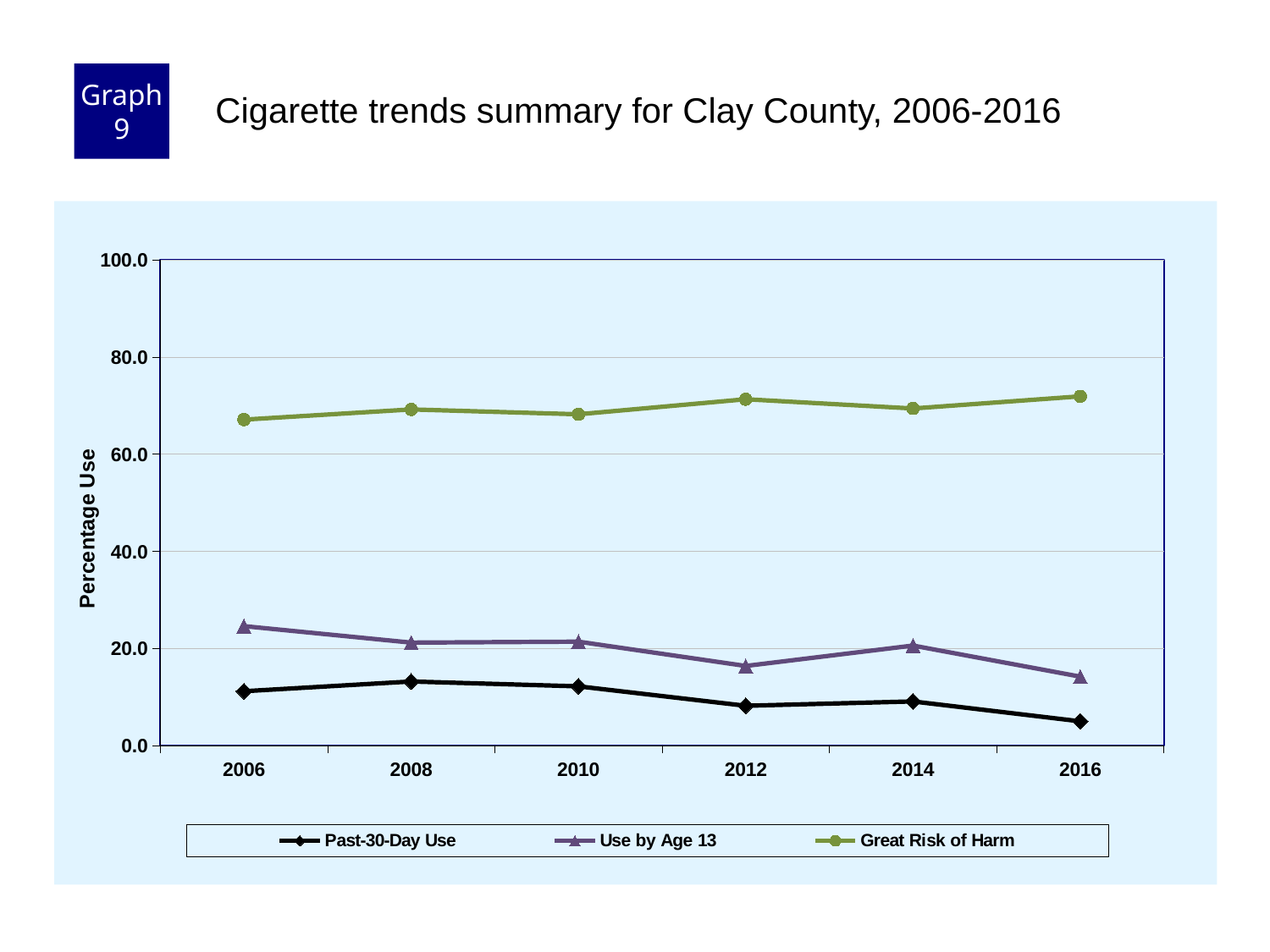
In 2014, which is larger: Use by Age 13 or Past-30-Day Use? Use by Age 13 How many series does the legend list? 3 In which year is Past-30-Day Use lowest? 2016 How many years are plotted along the x axis? 6 What kind of chart is shown on the slide? Line chart Does Past-30-Day Use rise or fall overall from 2006 to 2016? Fall Is the value for Use by Age 13 in 2016 greater or less than 20? less Is the value for Past-30-Day Use in 2006 greater or less than 20? less What is the label on the y axis? Percentage Use In which year is Use by Age 13 highest? 2006 Is the value for Use by Age 13 in 2006 greater or less than 20? greater